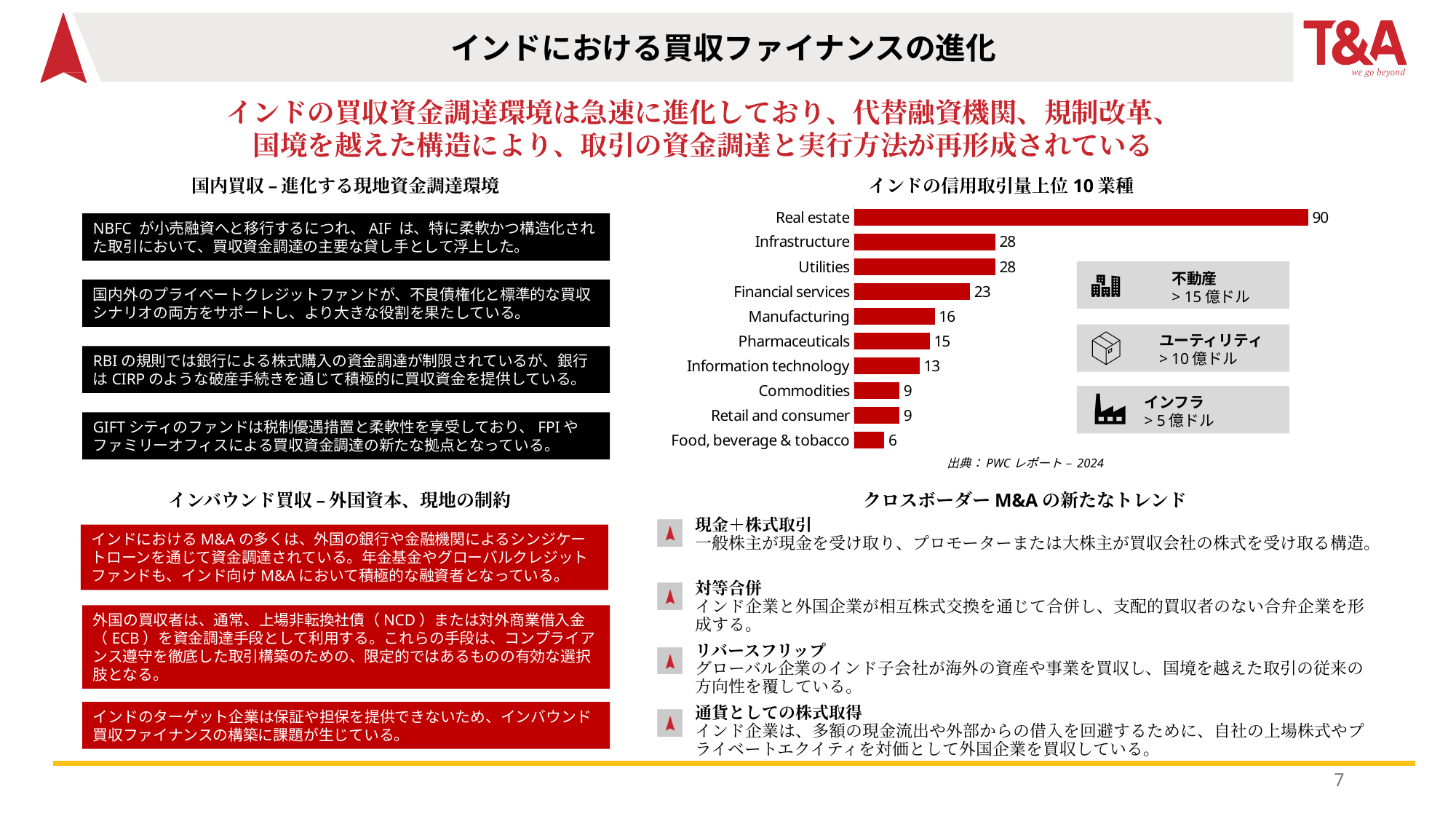
What is the difference between the values for Manufacturing and Pharmaceuticals? 1 Which category has the highest value in the bar chart? Real estate What kind of chart is shown on the slide? Bar chart Which has a larger value, Financial services or Manufacturing? Financial services What is the value for Real estate in the bar chart? 90 What is the difference between the values for Real estate and Infrastructure? 62 What is the source cited below the chart? PWC レポート – 2024 What is the value for Information technology in the bar chart? 13 Which category has the lowest value in the bar chart? Food, beverage & tobacco What is the title of the chart on the slide? インドの信用取引量上位 10 業種 How many categories are shown in the bar chart? 10 What is the value for Financial services in the bar chart? 23